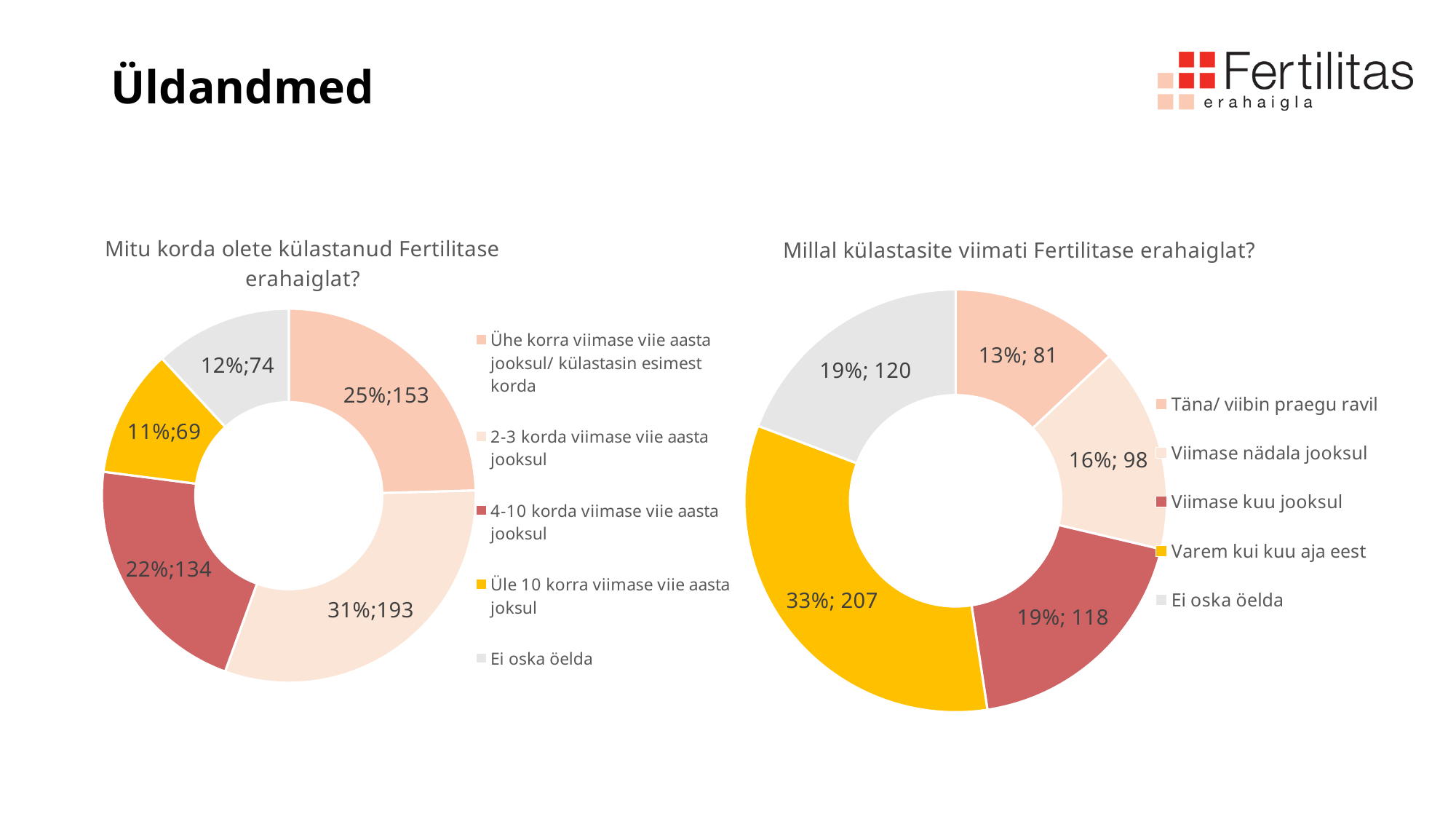
What type of chart is the one titled "Mitu korda olete külastanud Fertilitase erahaiglat?"? Doughnut (pie) chart In the chart titled "Mitu korda olete külastanud Fertilitase erahaiglat?", what is the difference in count between "4-10 korda viimase viie aasta jooksul" (134) and "Ei oska öelda" (74)? 60 In the chart titled "Millal külastasite viimati Fertilitase erahaiglat?", which is larger: "Viimase nädala jooksul" or "Viimase kuu jooksul"? Viimase kuu jooksul In the chart titled "Millal külastasite viimati Fertilitase erahaiglat?", what is the difference in count between "Varem kui kuu aja eest" (207) and "Ei oska öelda" (120)? 87 In the chart titled "Millal külastasite viimati Fertilitase erahaiglat?", what is the data label for "Täna/ viibin praegu ravil"? 13%; 81 In the chart titled "Mitu korda olete külastanud Fertilitase erahaiglat?", which category has the smallest slice? Üle 10 korra viimase viie aasta joksul In the chart titled "Millal külastasite viimati Fertilitase erahaiglat?", what colour is the "Varem kui kuu aja eest" slice? Yellow In the chart titled "Mitu korda olete külastanud Fertilitase erahaiglat?", how many categories are shown? 5 In the chart titled "Mitu korda olete külastanud Fertilitase erahaiglat?", what is the data label for "2-3 korda viimase viie aasta jooksul"? 31%;193 In the chart titled "Millal külastasite viimati Fertilitase erahaiglat?", which category has the smallest share? Täna/ viibin praegu ravil In the chart titled "Mitu korda olete külastanud Fertilitase erahaiglat?", which category has the largest slice? 2-3 korda viimase viie aasta jooksul In the chart titled "Millal külastasite viimati Fertilitase erahaiglat?", what is the data label for "Varem kui kuu aja eest"? 33%; 207